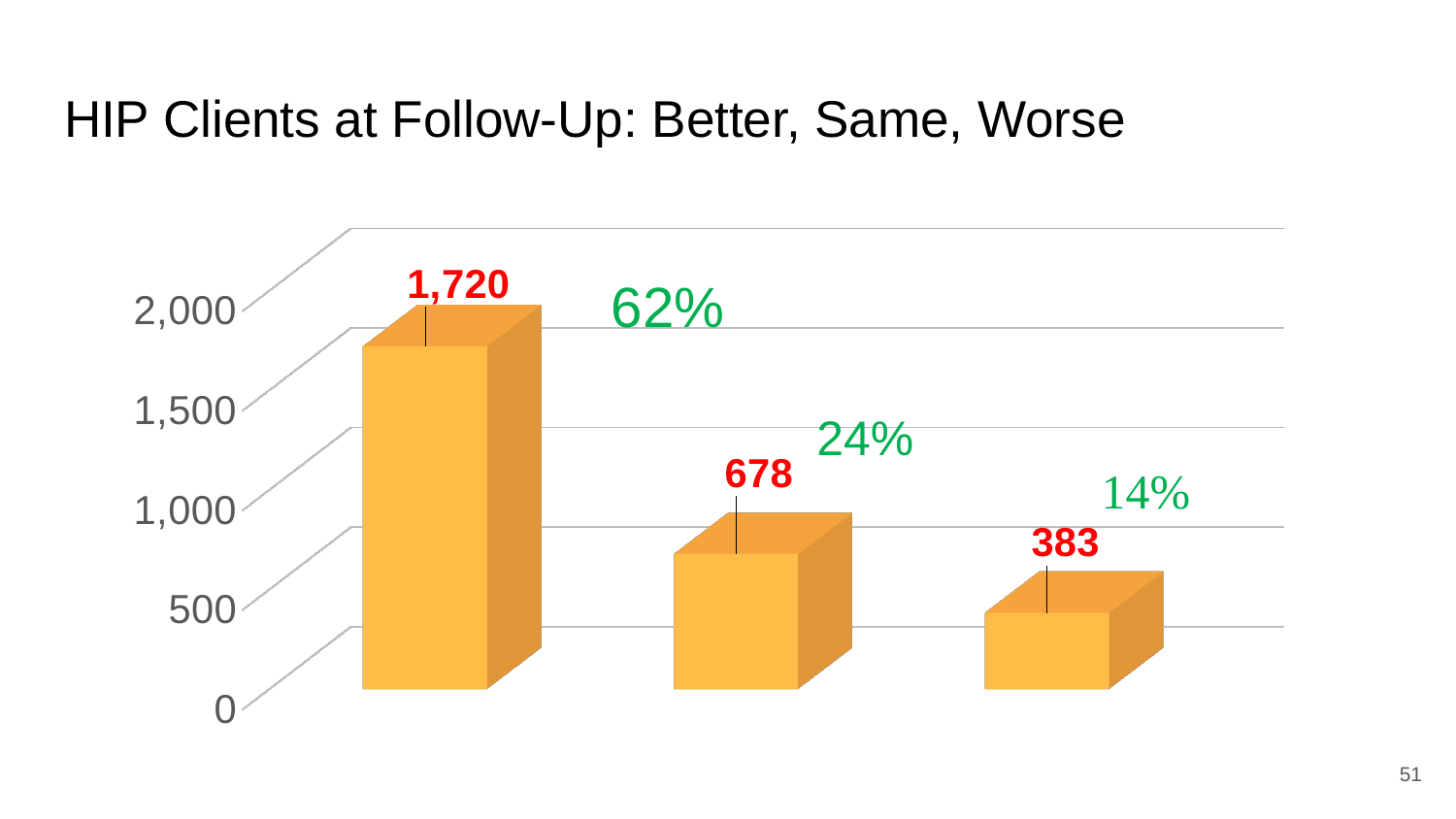
Is the value of the middle bar greater or less than 1,000? less What is the value shown on the tallest (leftmost) bar? 1,720 What is the title of the slide containing the chart? HIP Clients at Follow-Up: Better, Same, Worse How many bars are plotted in the chart? 3 What percentage is printed next to the rightmost bar? 14% Which bar has the lowest value: the left, middle, or right one? right What is the difference between the leftmost bar's value and the middle bar's value? 1,042 What is the value shown on the rightmost bar? 383 What is the value shown on the middle bar? 678 What percentage is printed next to the leftmost bar? 62% Which bar has the highest value: the left, middle, or right one? left What is the difference between the middle bar's value and the rightmost bar's value? 295